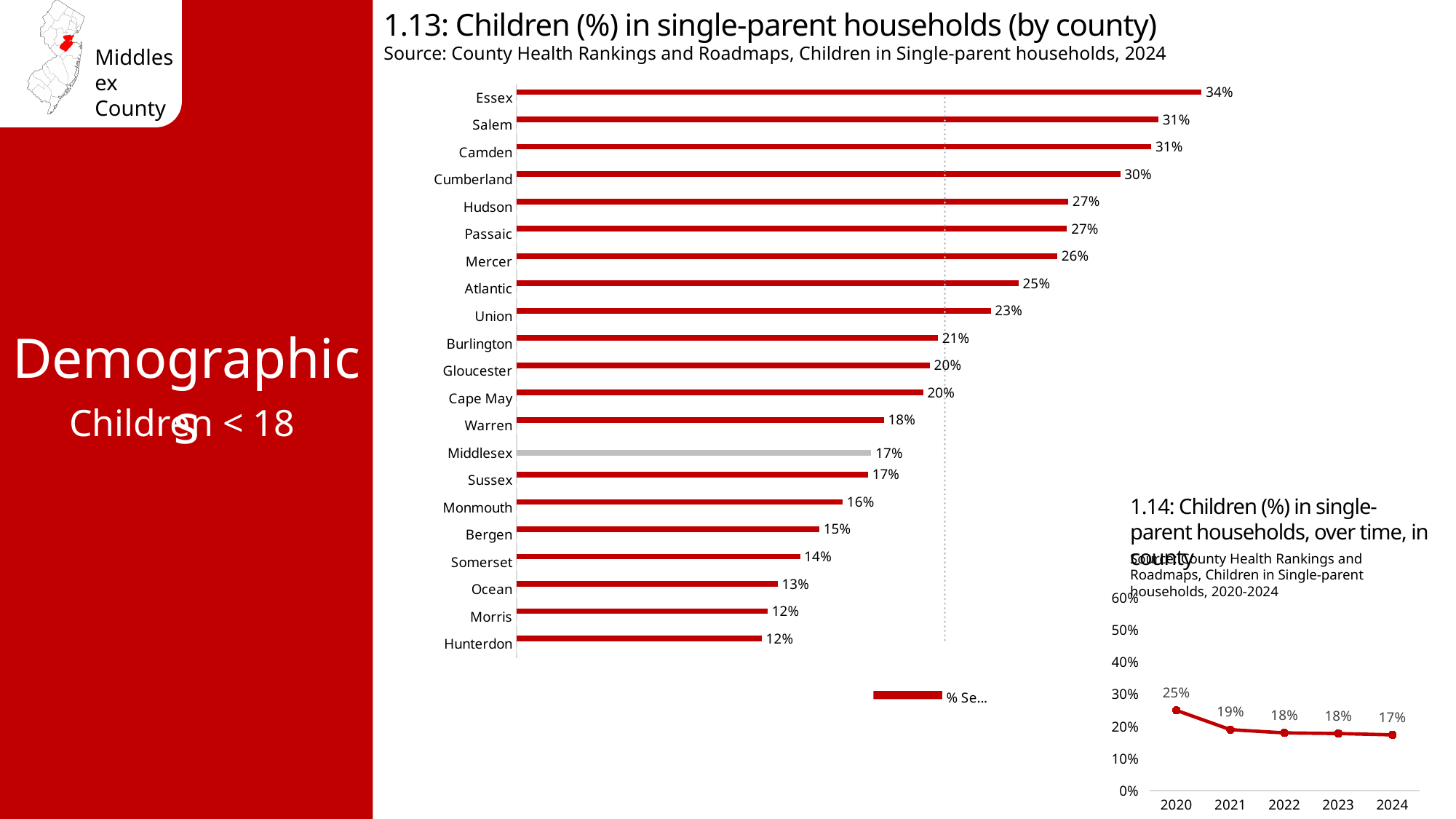
What kind of chart is chart 1.13? Bar chart In chart 1.13, what is the value for Hudson? 27% In chart 1.13, which county has the highest percentage of children in single-parent households? Essex In chart 1.13, what is the difference between the values for Essex and Middlesex? 17 percentage points In chart 1.13, what is the value for Cumberland? 30% In chart 1.14, do the values rise or fall from 2020 to 2024? Fall In chart 1.13, how many counties are shown? 21 In chart 1.14, how many years are plotted? 5 In chart 1.13, which is larger, the value for Union or the value for Burlington? Union In chart 1.14 (Children (%) in single-parent households over time), what is the value for 2020? 25% In chart 1.13 (Children (%) in single-parent households by county), what is the value for Middlesex? 17% In chart 1.14, what is the difference between the values for 2020 and 2024? 8 percentage points